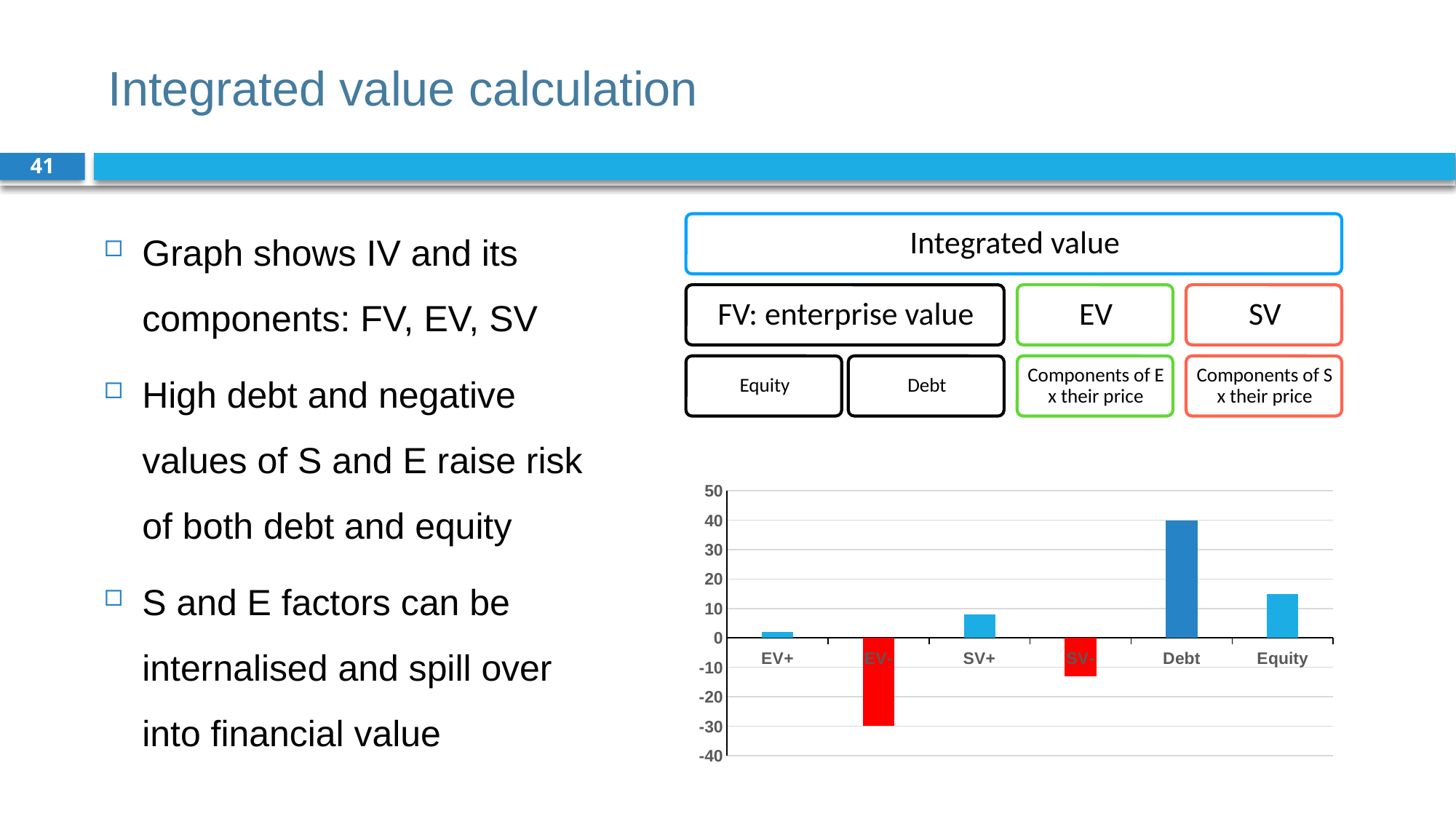
What kind of chart is shown on the slide? bar chart Which is larger, the value for EV+ or the value for SV+? SV+ What colour are the bars for EV- and SV- in the chart? red Which category has the lowest value in the bar chart? EV- Is the value for SV+ greater or less than 10? less Which is larger, the value for Equity or the value for SV+? Equity Which category has the highest value in the bar chart? Debt What is the value for Debt in the bar chart? 40 How many categories are shown on the x axis of the bar chart? 6 Is the value for Equity greater or less than 10? greater Is the value for SV- greater or less than -20? greater What is the value for EV- in the bar chart? -30